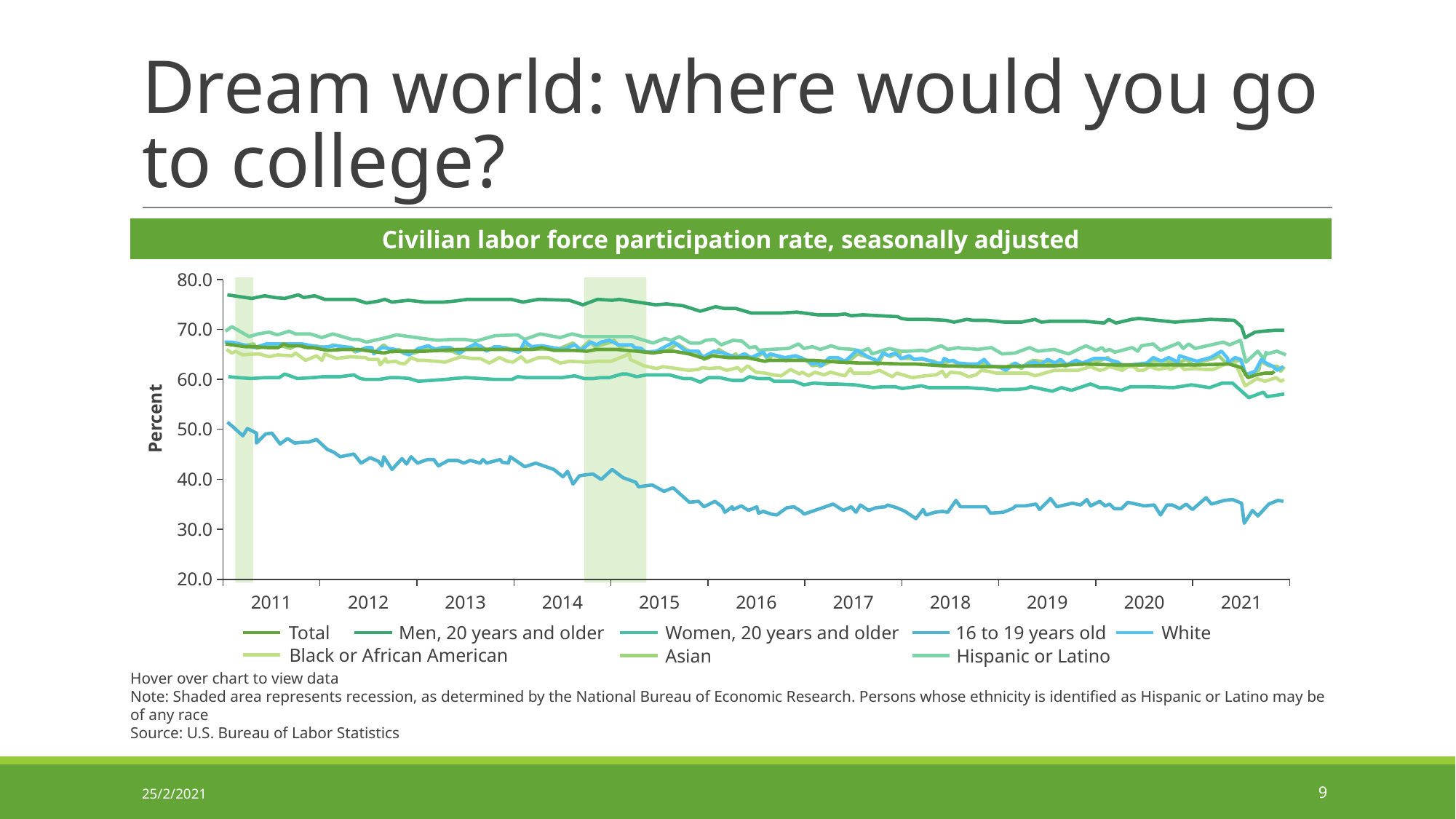
Is the value for 16 to 19 years old in 2017 greater or less than 40.0? less Which series has larger values in 2018, Men, 20 years and older or Women, 20 years and older? Men, 20 years and older What is the label on the vertical axis? Percent What kind of chart is shown on the slide? line chart Is the value for 16 to 19 years old at the start of 2011 greater or less than 40.0? greater How many series does the legend list? 8 How many year labels are shown on the x axis? 11 Which series has the highest values throughout the chart? Men, 20 years and older Is the value for Men, 20 years and older in 2012 greater or less than 70.0? greater What is the title of the chart? Civilian labor force participation rate, seasonally adjusted Which series has the lowest values throughout the chart? 16 to 19 years old Does the 16 to 19 years old series rise or fall from 2011 to 2016? fall